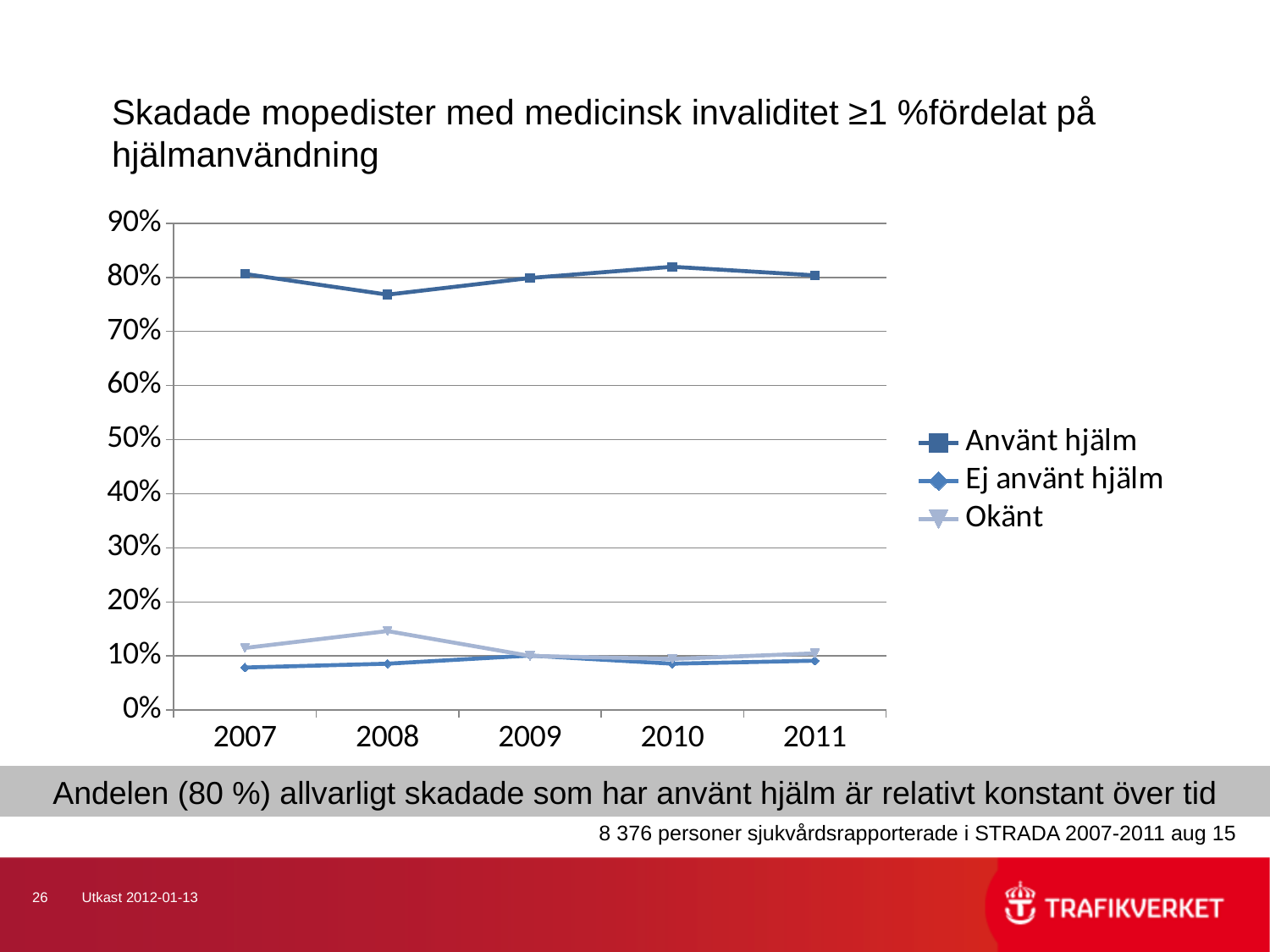
How many series does the legend list? 3 In which year is the value for Okänt highest? 2008 Is the value for Ej använt hjälm in 2007 greater or less than 10%? less Which series is highest in every year shown? Använt hjälm Is the value for Okänt in 2008 greater or less than 10%? greater What kind of chart is shown on the slide? line chart Does the value for Använt hjälm rise or fall from 2007 to 2008? fall How many years are plotted along the x axis? 5 Is the value for Använt hjälm in 2008 greater or less than 80%? less In which year is the value for Använt hjälm lowest? 2008 In 2008, which is larger: Okänt or Ej använt hjälm? Okänt